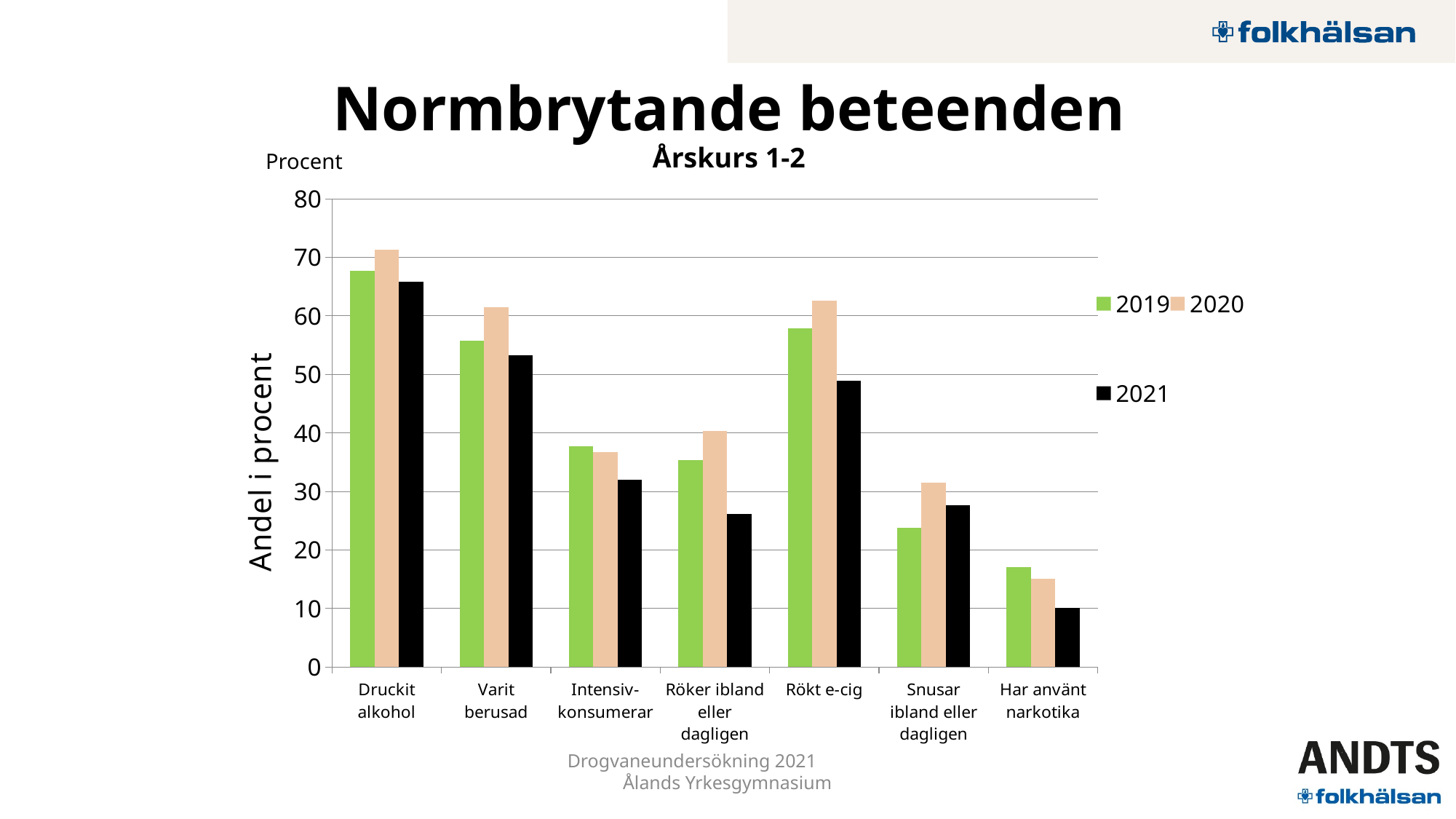
Which category has the highest value for 2021? Druckit alkohol For Intensivkonsumerar, which is larger: the 2019 value or the 2021 value? 2019 Is the 2020 value for Varit berusad greater or less than 60? greater For Snusar ibland eller dagligen, which is larger: the 2019 value or the 2020 value? 2020 For Har använt narkotika, do the values rise or fall from 2019 to 2021? fall What kind of chart is shown on the slide? bar chart What is the label on the vertical axis of the chart? Andel i procent How many behaviour categories are shown along the x axis? 7 Is the 2019 value for Snusar ibland eller dagligen greater or less than 30? less How many series does the legend list? 3 Which category has the lowest value for 2020? Har använt narkotika Is the 2021 value for Druckit alkohol greater or less than 60? greater